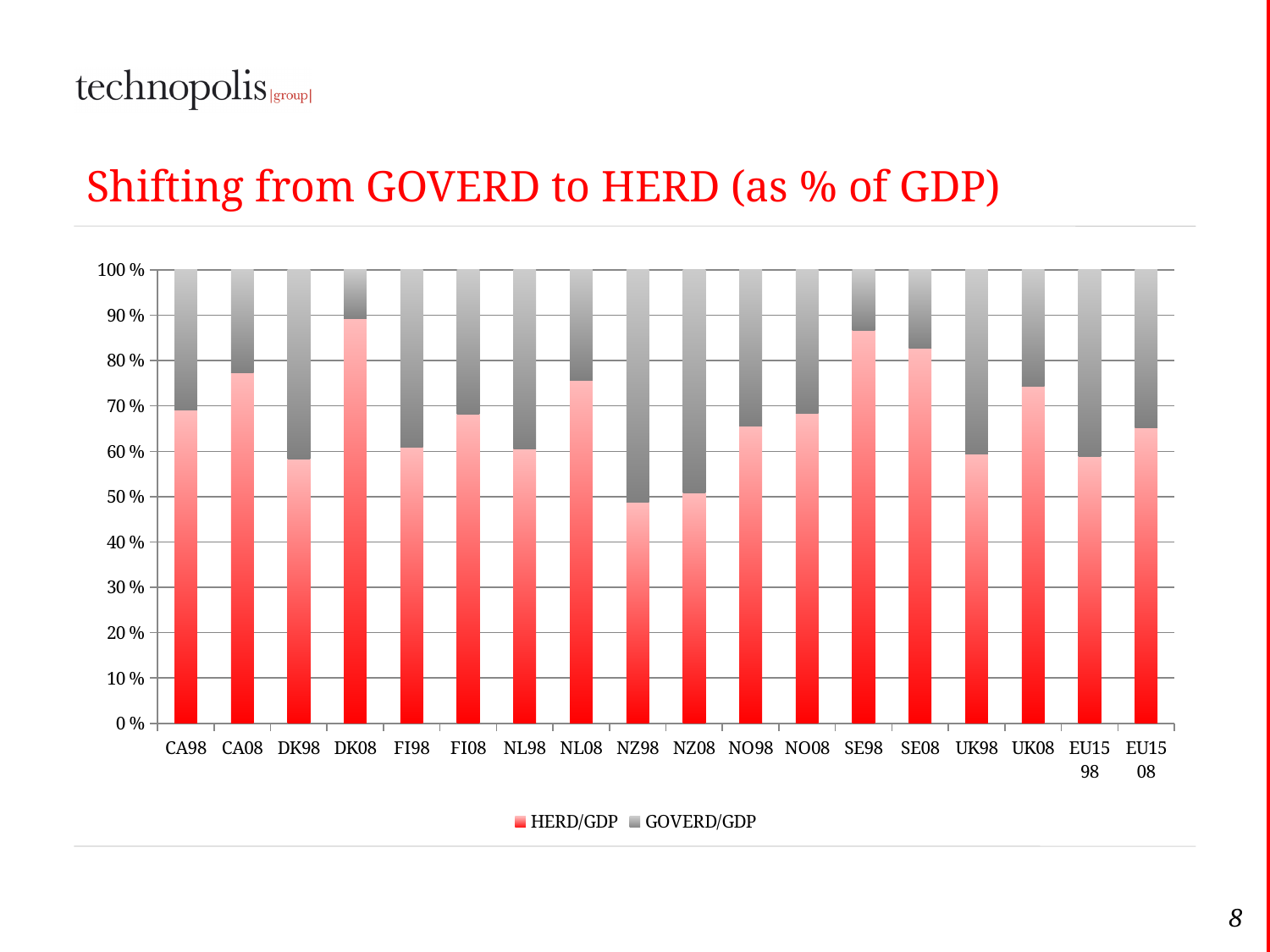
What is the total of the stacked bar for CA98? 100 % Which series is shown in red in the chart? HERD/GDP Which category has the highest HERD/GDP share? DK08 Is the HERD/GDP value for NZ98 greater or less than 60 %? less Is the HERD/GDP value for DK08 greater or less than 80 %? greater What kind of chart is shown on the slide? Stacked bar chart What is the title of the chart on the slide? Shifting from GOVERD to HERD (as % of GDP) How many series does the chart legend list? 2 Which has the larger HERD/GDP share, CA98 or CA08? CA08 Is the HERD/GDP value for CA08 greater or less than 70 %? greater Which has the larger GOVERD/GDP share, DK98 or DK08? DK98 How many categories are shown along the x axis of the chart? 18